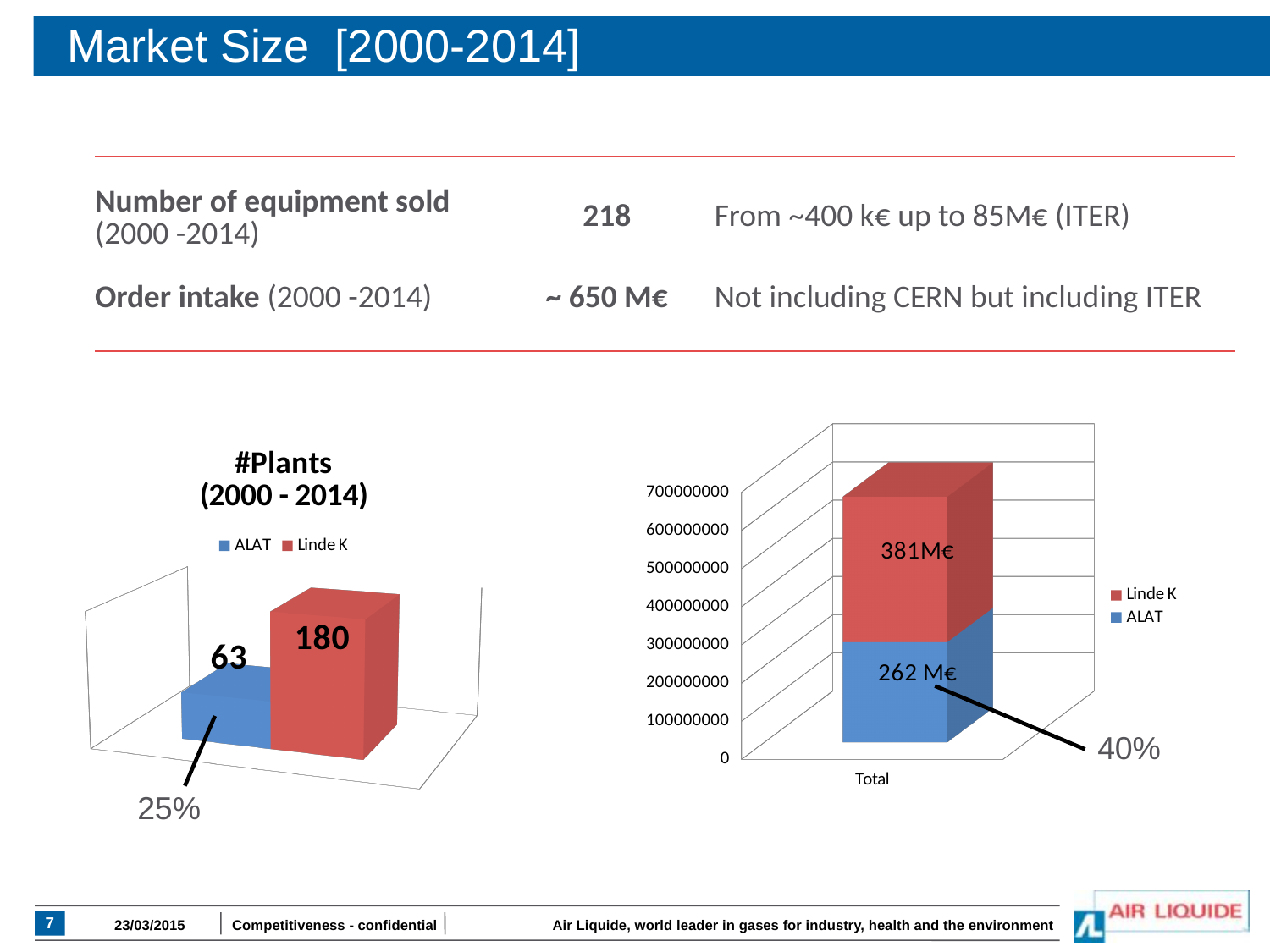
In the #Plants (2000 - 2014) chart, which series has the higher number of plants? Linde K What kind of chart is the #Plants (2000 - 2014) chart? Bar chart In the chart on the right of the slide, which series is shown in blue? ALAT In the #Plants (2000 - 2014) chart, how many series does the legend list? 2 In the #Plants (2000 - 2014) chart, what is the difference between the Linde K and ALAT values? 117 In the chart on the right of the slide, is the top of the stacked bar greater or less than 600000000? greater In the #Plants (2000 - 2014) chart, what is the value for Linde K? 180 In the chart on the right of the slide, what is the category label on the x axis? Total In the chart on the right of the slide, which series has the larger value, Linde K or ALAT? Linde K In the chart on the right of the slide, what is the value labelled for ALAT? 262 M€ In the #Plants (2000 - 2014) chart, what is the value for ALAT? 63 In the chart on the right of the slide, what is the value labelled for Linde K? 381M€